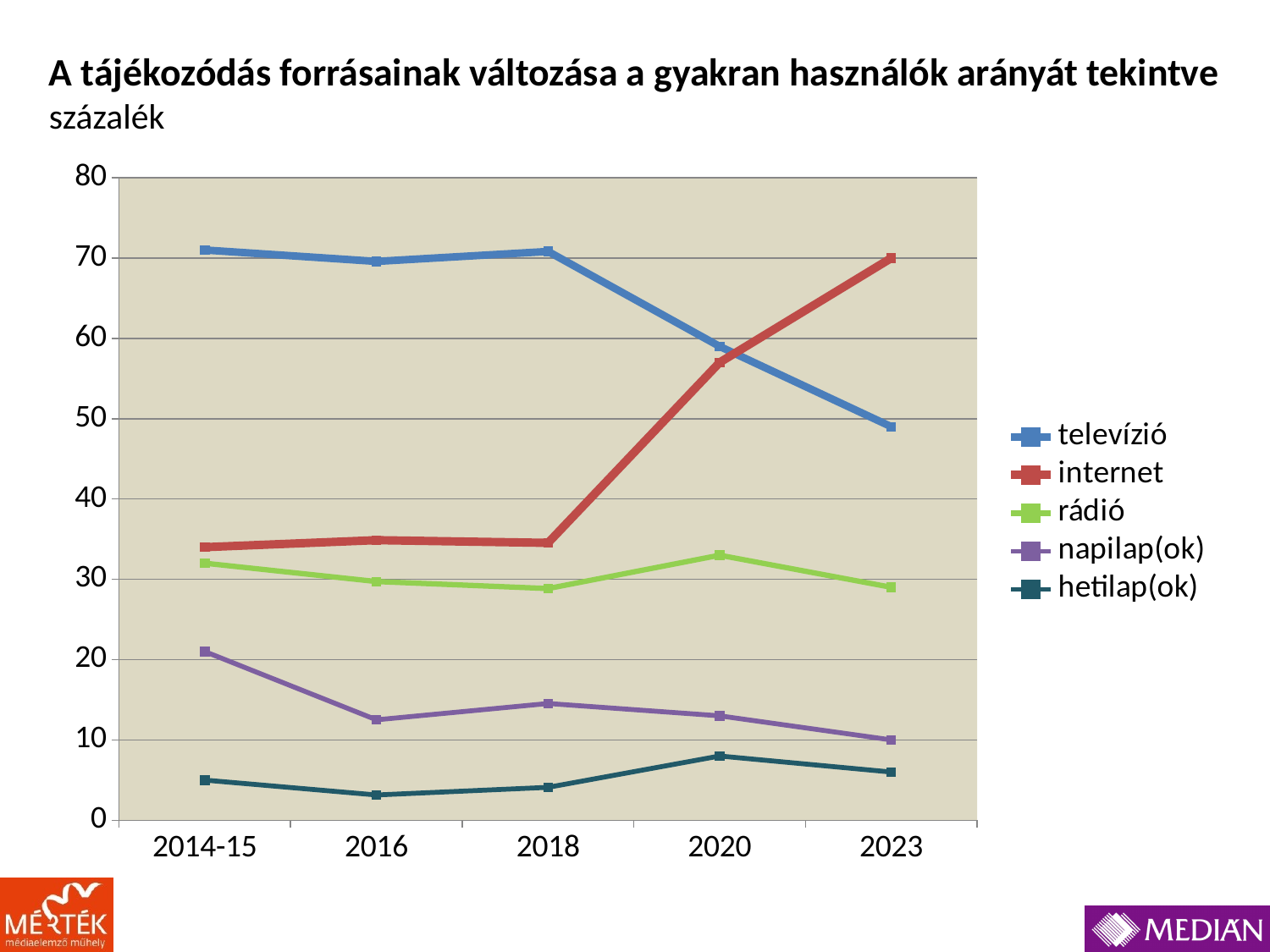
Which series has the highest value in 2023? internet Is the value for internet in 2018 greater or less than 40? less Which is larger in 2020, the value for televízió or the value for internet? televízió How many points are there along the x axis? 5 Is the value for rádió in 2020 greater or less than 30? greater Which series has the lowest value in 2014-15? hetilap(ok) Does the televízió series rise or fall from 2018 to 2023? fall What kind of chart is shown on the slide? line chart Which series is drawn in red? internet How many series does the legend list? 5